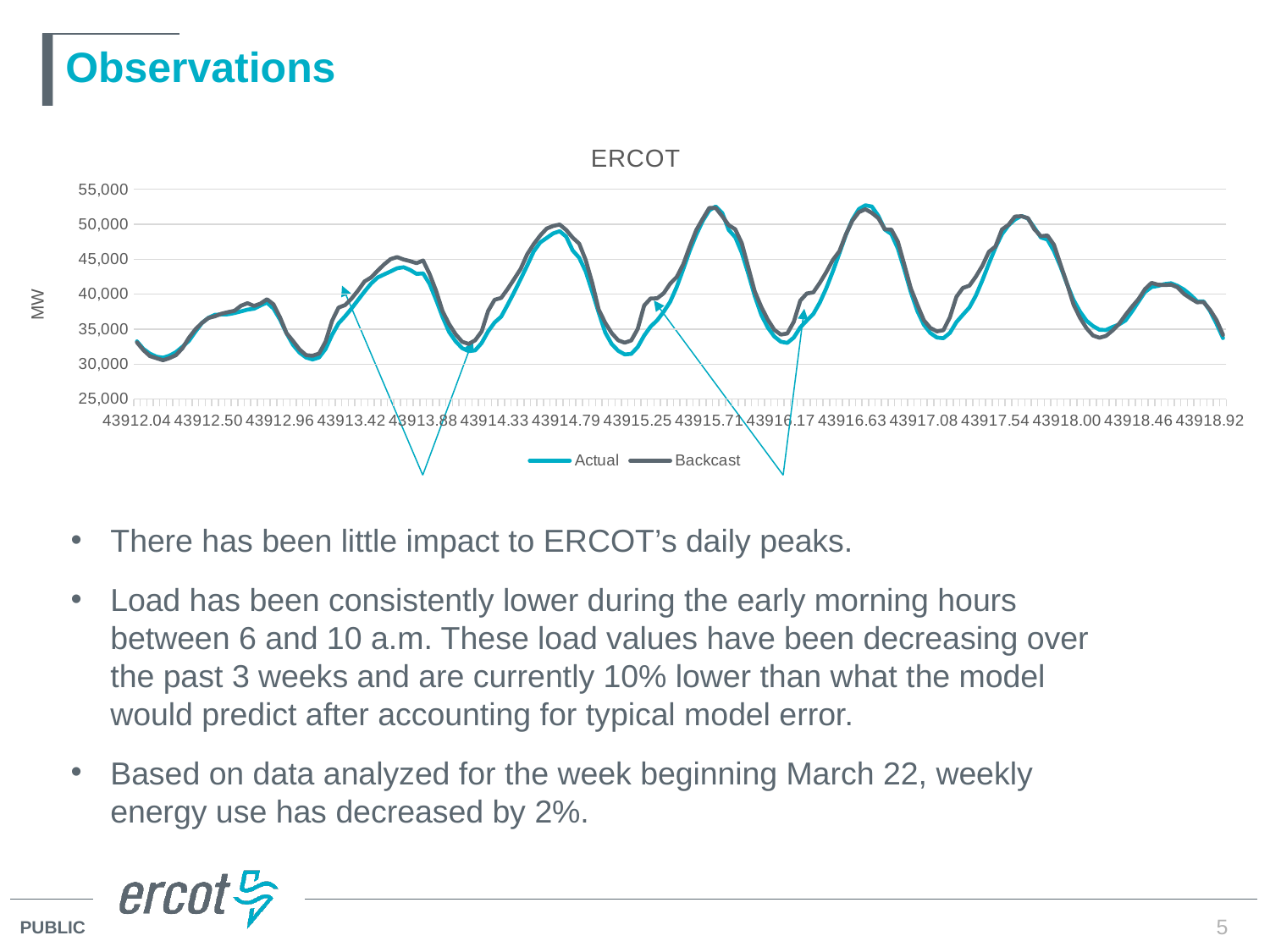
What unit is shown on the chart's vertical axis label? MW Is the highest value reached by the Backcast series greater or less than 55,000? less How many tick labels are printed along the chart's x axis? 16 Around the x-axis label 43916.17, which series is lower, Actual or Backcast? Actual Is the highest value reached by the Actual series greater or less than 50,000? greater What is the title of the chart? ERCOT How many series does the chart's legend list? 2 What is the first x-axis label on the chart? 43912.04 Is the lowest value reached by the Backcast series greater or less than 35,000? less What is the highest value printed on the chart's vertical axis? 55,000 Around the x-axis label 43913.42, which series is higher, Actual or Backcast? Backcast What kind of chart is shown on the slide? Line chart